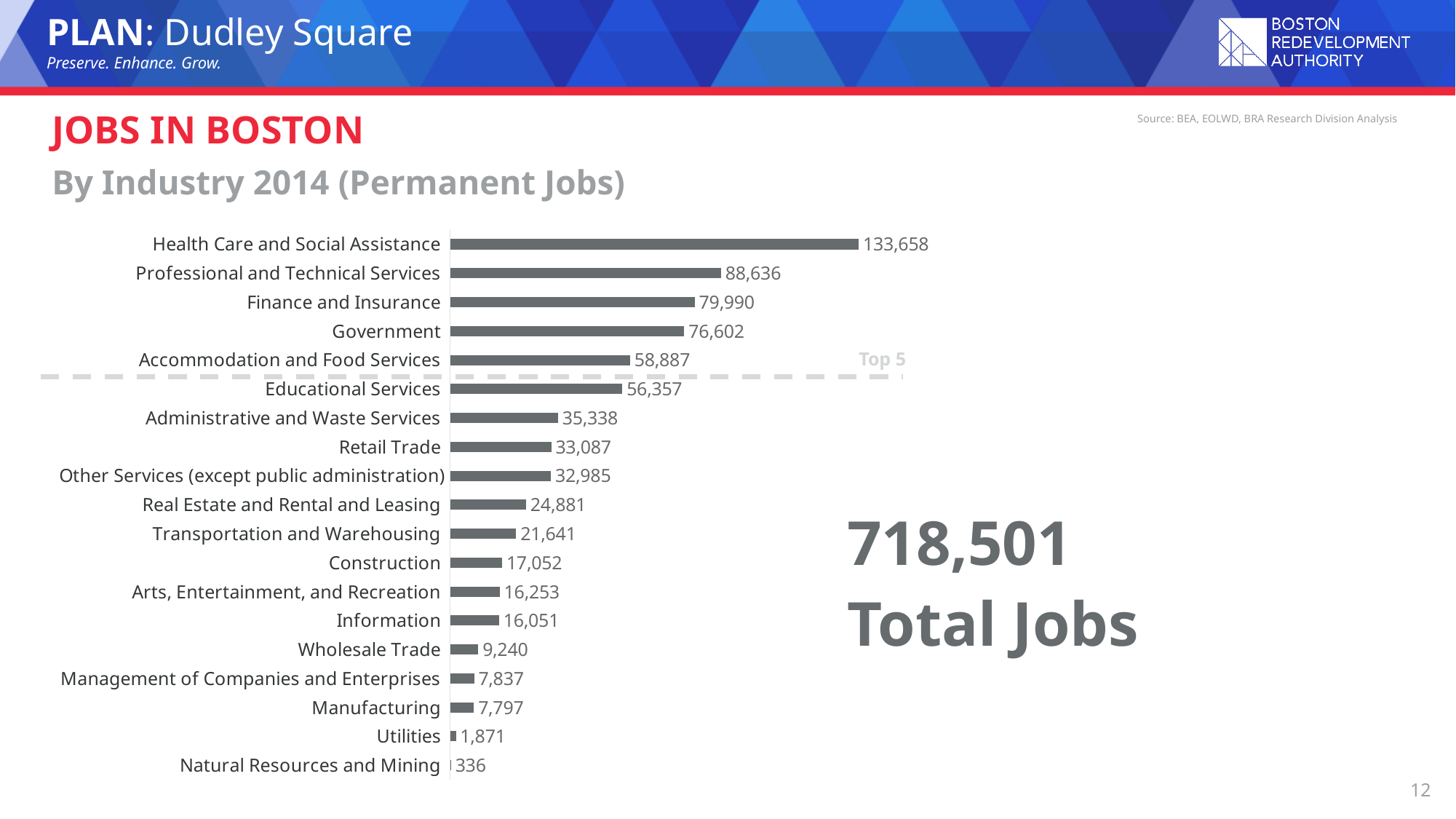
Which industry has the lowest number of jobs? Natural Resources and Mining What is the value for Utilities? 1,871 How many jobs are shown for Health Care and Social Assistance? 133,658 What is the value for Retail Trade? 33,087 What is the value for Government? 76,602 How many industries are shown in the chart? 19 What is the difference between Accommodation and Food Services and Educational Services? 2,530 What is the difference between Health Care and Social Assistance and Professional and Technical Services? 45,022 Which is larger, Finance and Insurance or Government? Finance and Insurance What total number of jobs is stated on the slide? 718,501 Which industry has the highest number of jobs? Health Care and Social Assistance What kind of chart is shown on the slide? Bar chart